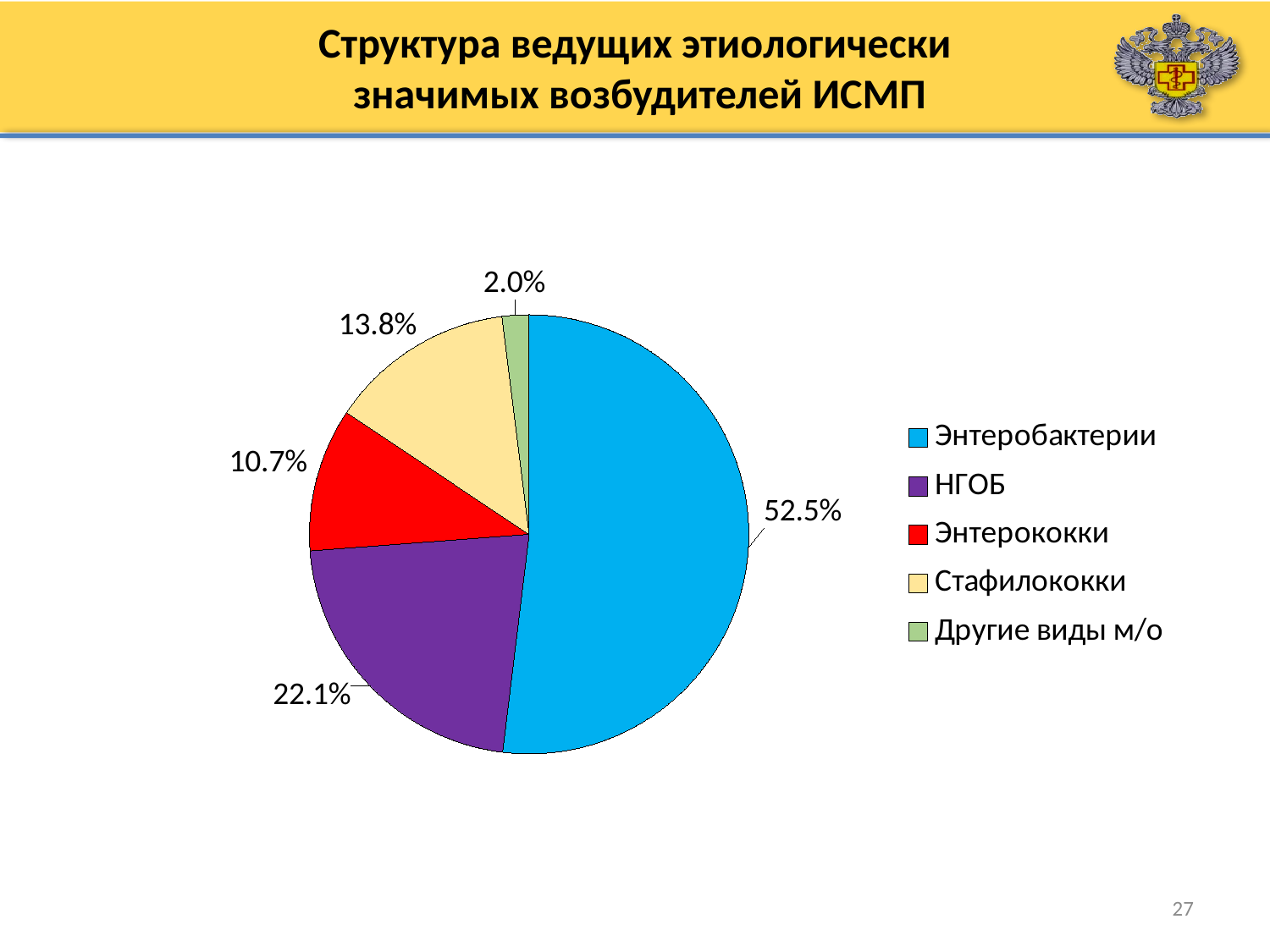
What type of chart is shown on the slide? pie chart What share of the pie does Энтерококки have? 10.7% How many categories does the legend list? 5 What colour is the slice for Энтерококки? red What is the difference in percentage points between the shares of Энтеробактерии and НГОБ? 30.4 Which category has the smallest slice of the pie? Другие виды м/о What share of the pie does НГОБ have? 22.1% What share of the pie does Другие виды м/о have? 2.0% Which category has the largest slice of the pie? Энтеробактерии What share of the pie does Стафилококки have? 13.8% Which is larger, the share for Стафилококки or the share for Энтерококки? Стафилококки What share of the pie does Энтеробактерии have? 52.5%